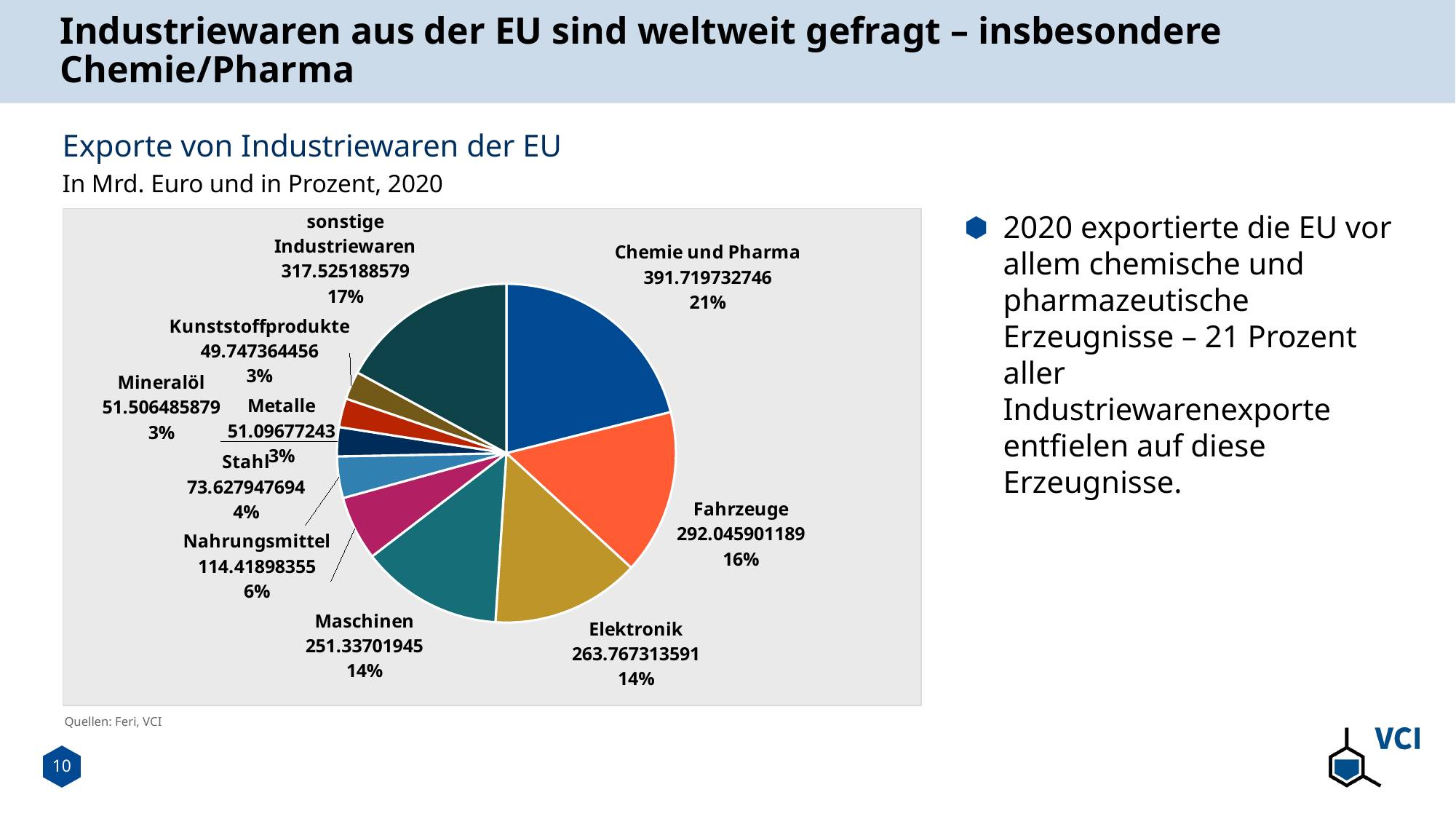
What share of the pie does sonstige Industriewaren account for? 17% What is the title of the chart? Exporte von Industriewaren der EU What share of the pie does Chemie und Pharma account for? 21% What is the value shown for Nahrungsmittel? 114.41898355 What is the value shown for Chemie und Pharma? 391.719732746 What kind of chart is shown on the slide? Pie chart How many categories (slices) does the pie chart have? 10 What is the value shown for Fahrzeuge? 292.045901189 Which category has the smallest value? Kunststoffprodukte What is the difference between the values for Chemie und Pharma and Fahrzeuge? 99.673831557 Which is larger, the value for Elektronik or the value for Maschinen? Elektronik Which category has the largest value? Chemie und Pharma